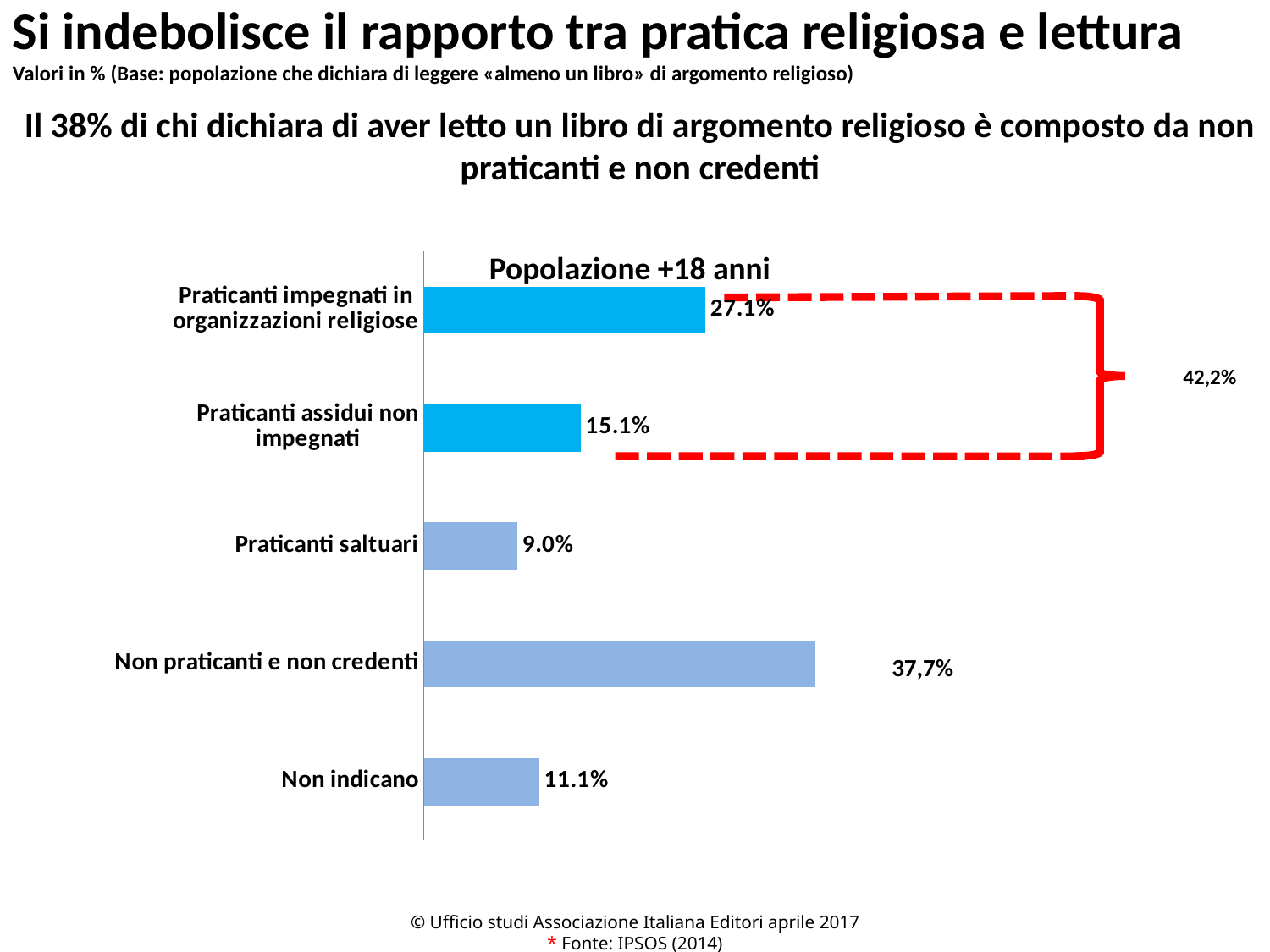
Which category has the lowest value? Praticanti saltuari What is the value for Praticanti impegnati in organizzazioni religiose? 27.1% What is the value for Praticanti saltuari? 9.0% Which category has the highest value? Non praticanti e non credenti What is the title of the chart? Popolazione +18 anni What is the difference between the values for Praticanti impegnati in organizzazioni religiose and Praticanti assidui non impegnati? 12.0% How many categories are shown in the chart? 5 What is the value for Praticanti assidui non impegnati? 15.1% What kind of chart is shown on the slide? Bar chart What is the value for Non indicano? 11.1% Which is larger, the value for Non indicano or the value for Praticanti saltuari? Non indicano What is the value for Non praticanti e non credenti? 37,7%